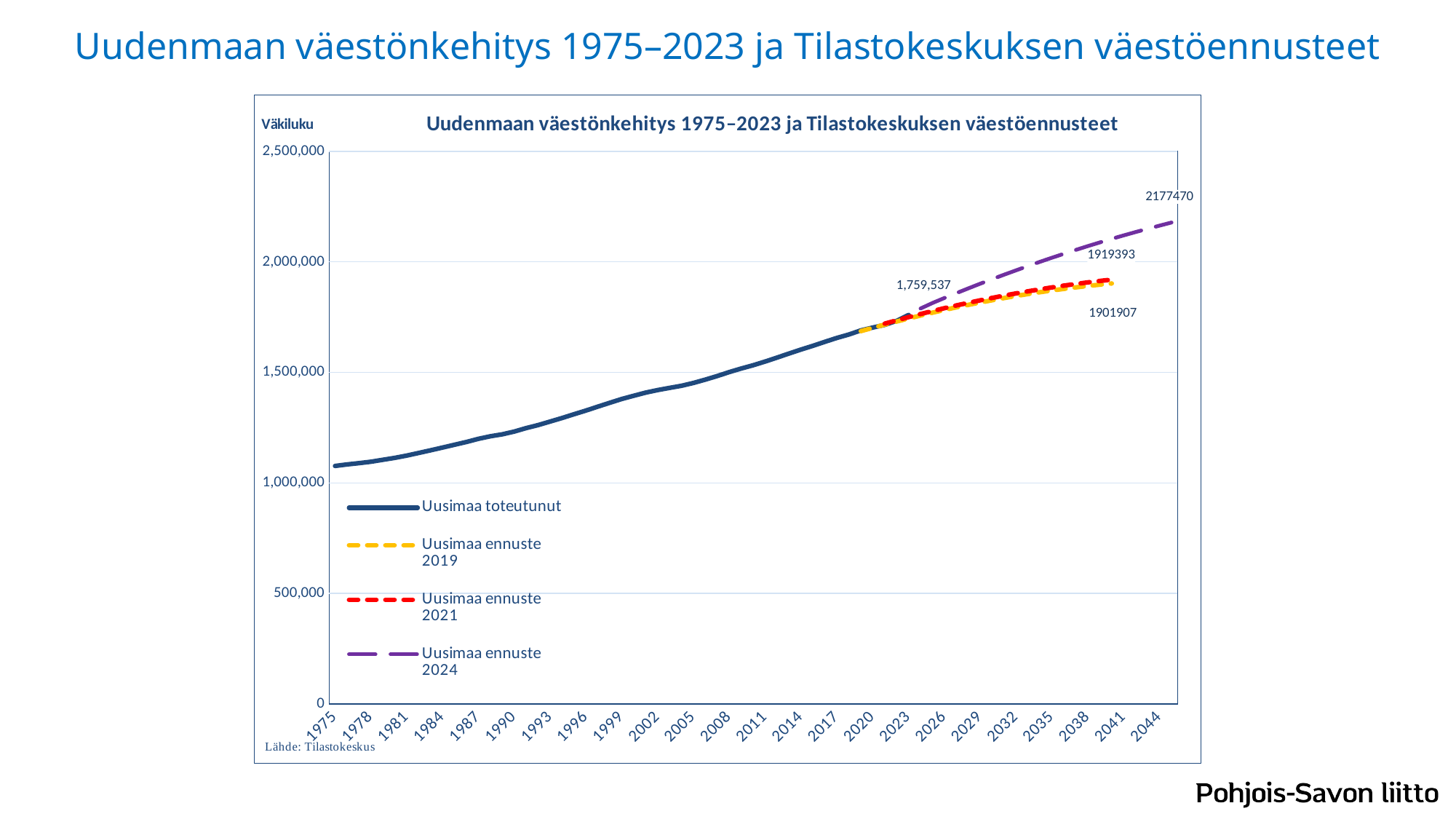
What type of chart is shown on the slide? line chart What is the labelled value of the Uusimaa toteutunut series at its last point, around 2023? 1,759,537 What is the final labelled value of the Uusimaa ennuste 2024 series? 2177470 How many series does the legend list? 4 What is the label on the vertical axis of the chart? Väkiluku What is the final labelled value of the Uusimaa ennuste 2019 series? 1901907 Which forecast series ends at the highest value? Uusimaa ennuste 2024 Is the value of the Uusimaa toteutunut series in 1975 greater or less than 1,500,000? less Which ends higher, the Uusimaa ennuste 2021 series or the Uusimaa ennuste 2019 series? Uusimaa ennuste 2021 What is the difference between the end values of the Uusimaa ennuste 2024 series (2177470) and the Uusimaa ennuste 2021 series (1919393)? 258077 Does the Uusimaa toteutunut series rise or fall from 1975 to 2023? rise What is the final labelled value of the Uusimaa ennuste 2021 series? 1919393